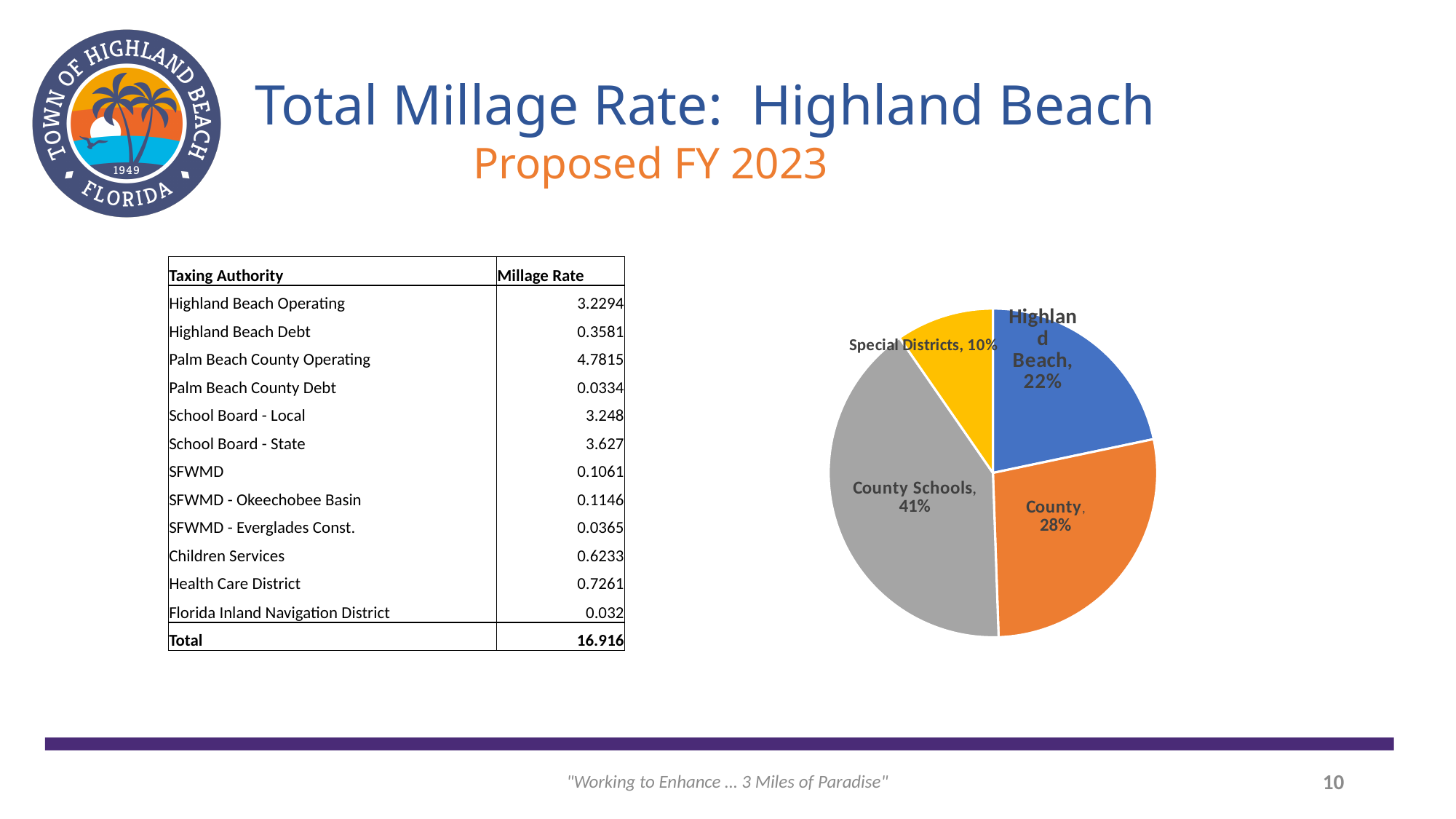
What share of the pie chart is Highland Beach? 22% Which slice of the pie chart is the smallest? Special Districts What share of the pie chart is County? 28% What share of the pie chart is County Schools? 41% Which slice of the pie chart is the largest? County Schools In the pie chart, what is the difference in percentage points between Highland Beach and Special Districts? 12 How many slices does the pie chart have? 4 In the pie chart, which is larger: County or Highland Beach? County What kind of chart is shown on the slide? pie chart In the pie chart, what is the difference in percentage points between County Schools and County? 13 What colour is the County Schools slice in the pie chart? grey